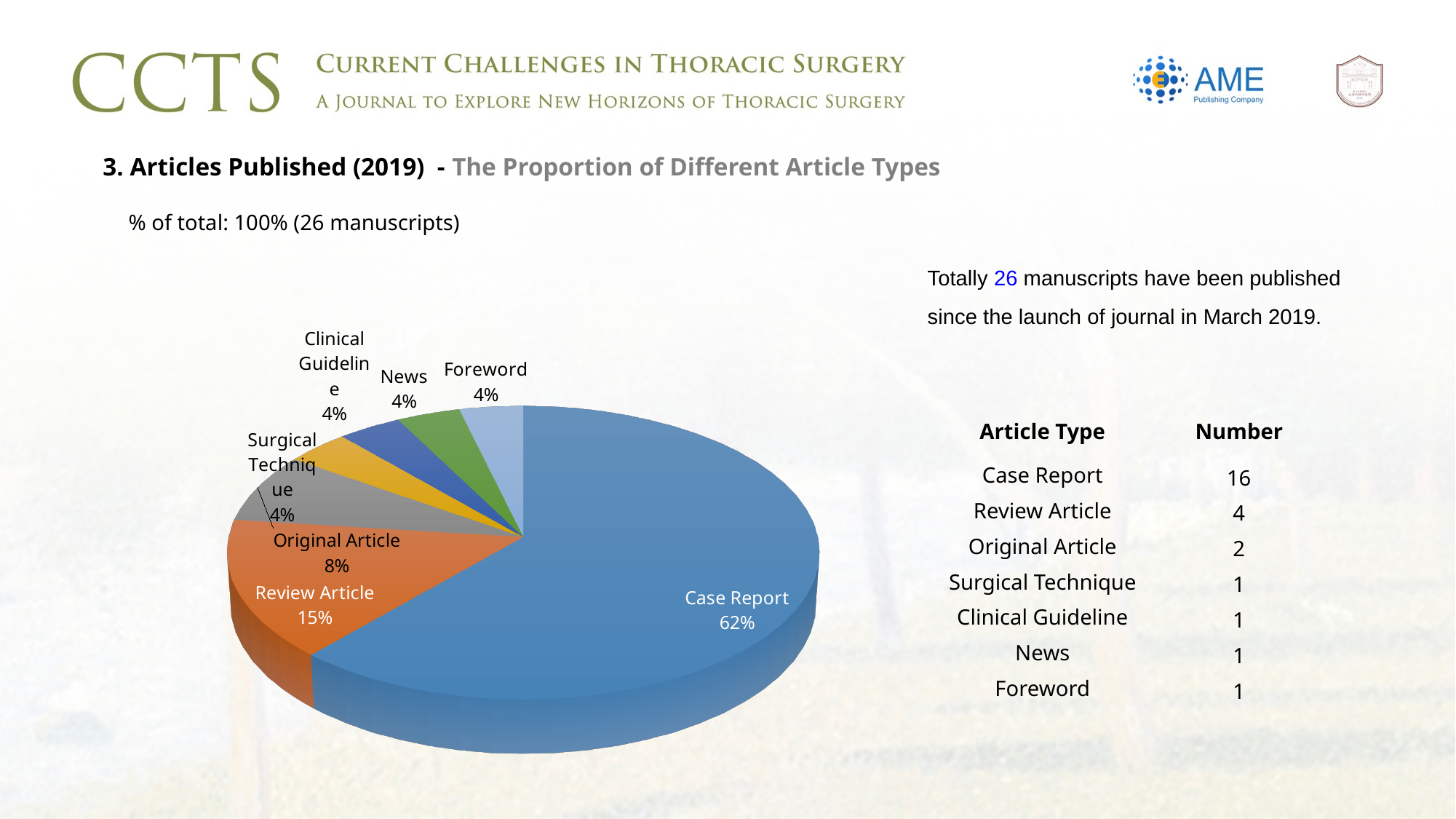
Which slice is larger, Review Article or Original Article? Review Article What kind of chart is shown on the slide? pie chart What is the difference in percentage points between the Case Report and Review Article slices? 47 How many manuscripts in total does the chart represent, according to the text above it? 26 What share of the pie does News account for? 4% What colour is the Case Report slice? blue Which article type has the largest slice of the pie? Case Report Is the share for Case Report greater or less than 50%? greater What share of the pie does Case Report account for? 62% What share of the pie does Original Article account for? 8% How many slices does the pie chart have? 7